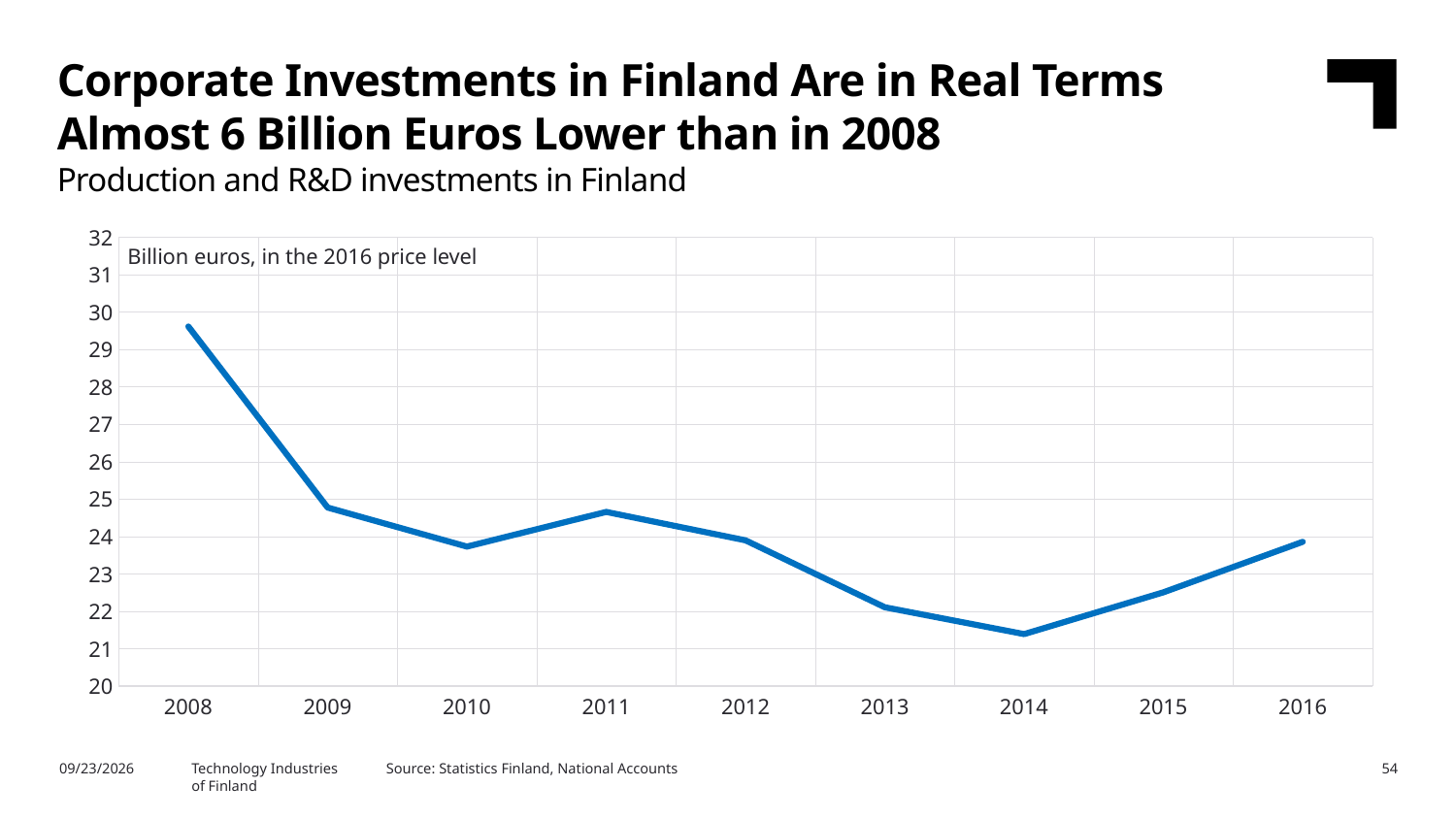
What unit is stated in the label inside the chart area? Billion euros, in the 2016 price level What kind of chart is shown on the slide? Line chart Which year has the larger value, 2009 or 2010? 2009 In which year is the value of production and R&D investments highest? 2008 How many years are plotted on the x axis of the chart? 9 Is the value for 2008 greater or less than 29? greater Do the values rise or fall from 2014 to 2016? Rise Which year has the larger value, 2008 or 2016? 2008 Is the value for 2013 greater or less than 23? less Is the value for 2014 greater or less than 22? less In which year is the value of production and R&D investments lowest? 2014